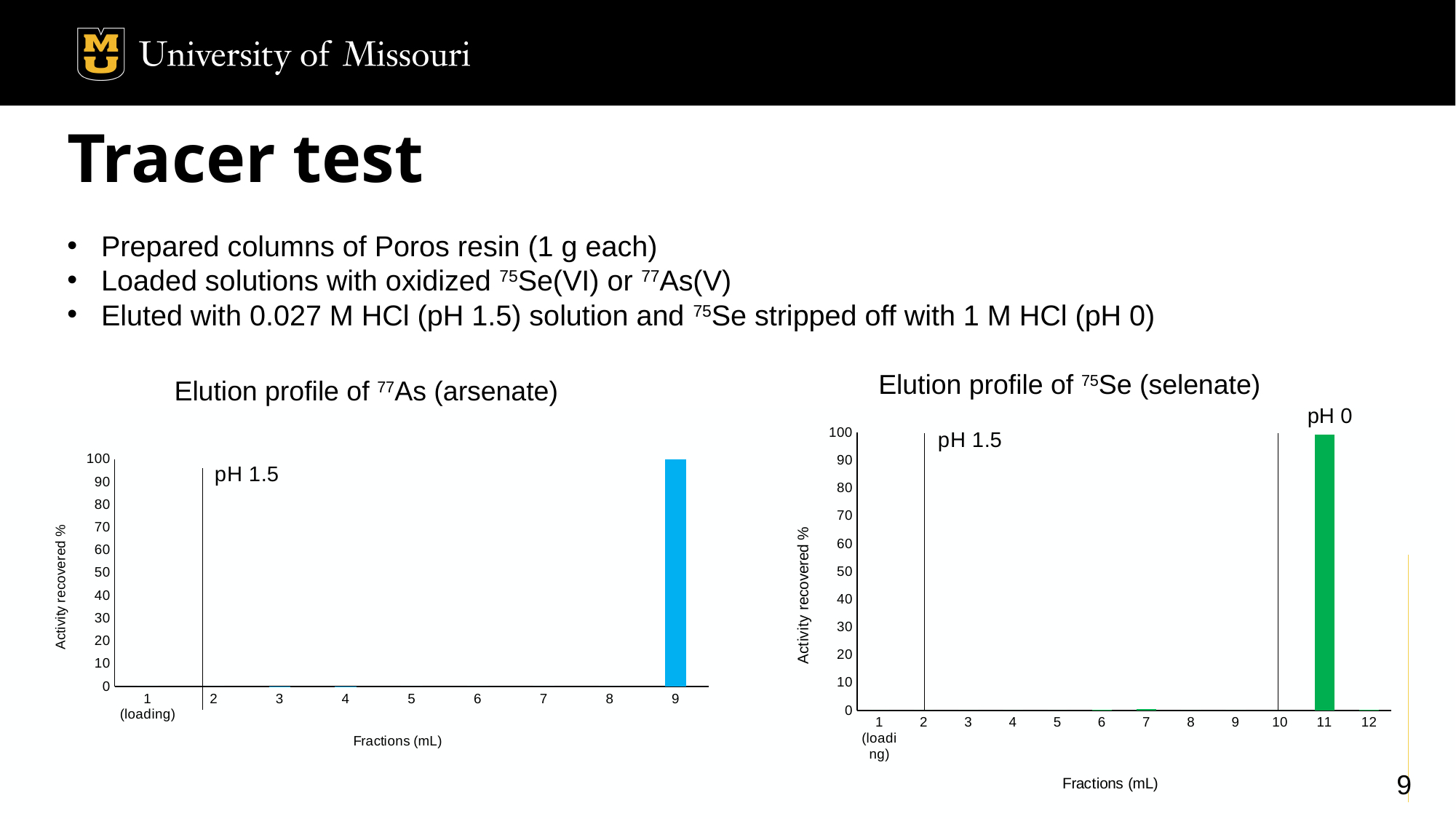
What kind of chart is the 'Elution profile of 77As (arsenate)' chart? bar chart How many fractions are shown on the x axis of the 'Elution profile of 75Se (selenate)' chart? 12 In the 'Elution profile of 77As (arsenate)' chart, which fraction has the highest activity recovered? 9 In the 'Elution profile of 77As (arsenate)' chart, is the value for fraction 9 greater or less than 50? greater What is the y-axis title of the 'Elution profile of 75Se (selenate)' chart? Activity recovered % In the 'Elution profile of 75Se (selenate)' chart, which fraction has the highest activity recovered? 11 In the 'Elution profile of 75Se (selenate)' chart, which is larger, the value for fraction 11 or the value for fraction 7? fraction 11 How many fractions are shown on the x axis of the 'Elution profile of 77As (arsenate)' chart? 9 What is the x-axis title of the 'Elution profile of 77As (arsenate)' chart? Fractions (mL) In the 'Elution profile of 75Se (selenate)' chart, is the value for fraction 7 greater or less than 10? less